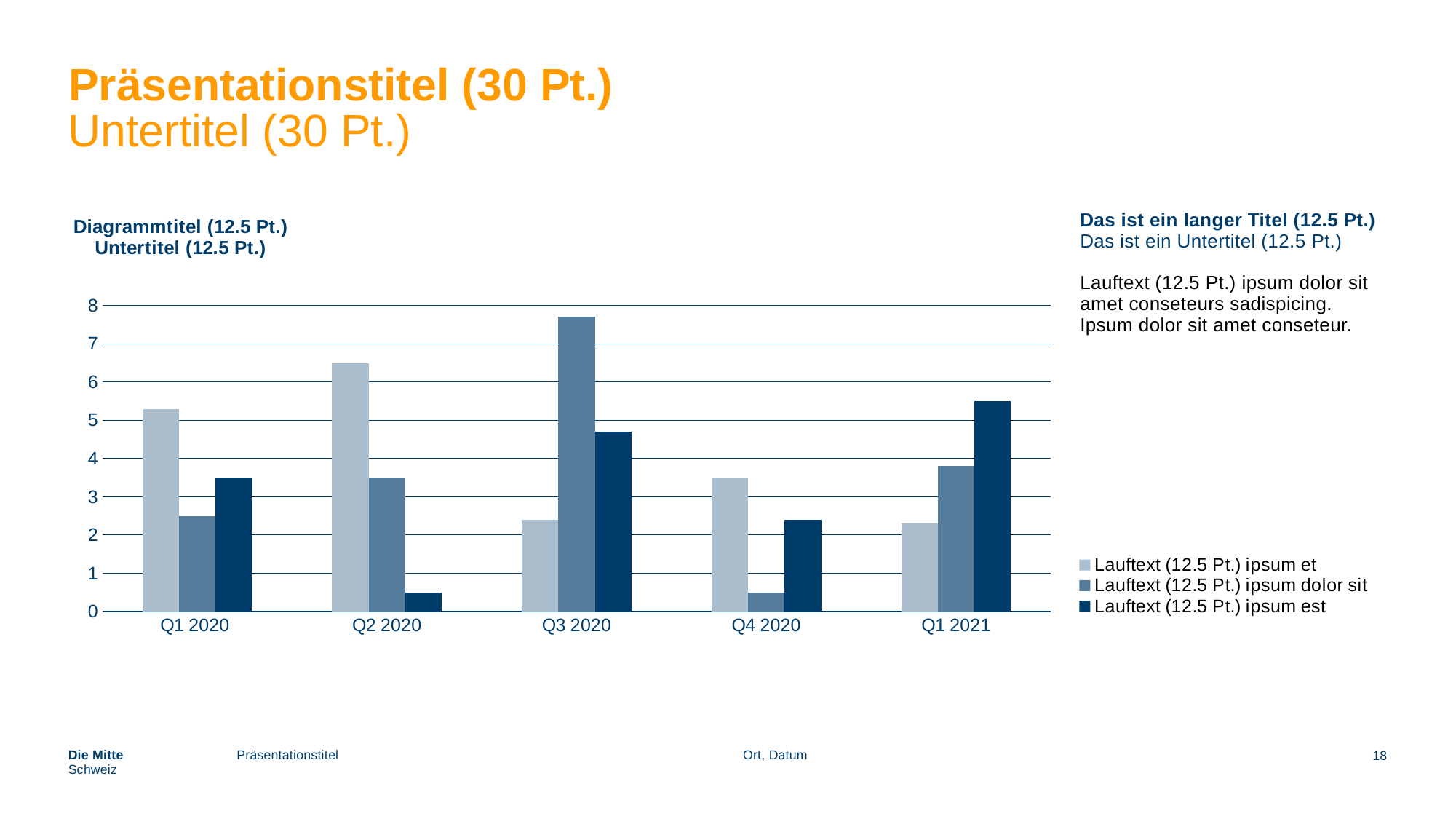
Is the value for "Lauftext (12.5 Pt.) ipsum dolor sit" in Q3 2020 greater or less than 7? greater Which category has the highest value for the series "Lauftext (12.5 Pt.) ipsum dolor sit"? Q3 2020 How many series does the chart's legend list? 3 How many categories are shown on the x axis of the chart? 5 Is the value for "Lauftext (12.5 Pt.) ipsum est" in Q1 2021 greater or less than 5? greater Which category has the highest value for the series "Lauftext (12.5 Pt.) ipsum est"? Q1 2021 Which category has the highest value for the series "Lauftext (12.5 Pt.) ipsum et"? Q2 2020 In Q1 2020, which series has the larger value: "Lauftext (12.5 Pt.) ipsum et" or "Lauftext (12.5 Pt.) ipsum est"? Lauftext (12.5 Pt.) ipsum et What is the title of the chart? Diagrammtitel (12.5 Pt.) Untertitel (12.5 Pt.) Is the value for "Lauftext (12.5 Pt.) ipsum et" in Q2 2020 greater or less than 6? greater What kind of chart is shown on the slide? Bar chart Which category has the lowest value for the series "Lauftext (12.5 Pt.) ipsum est"? Q2 2020